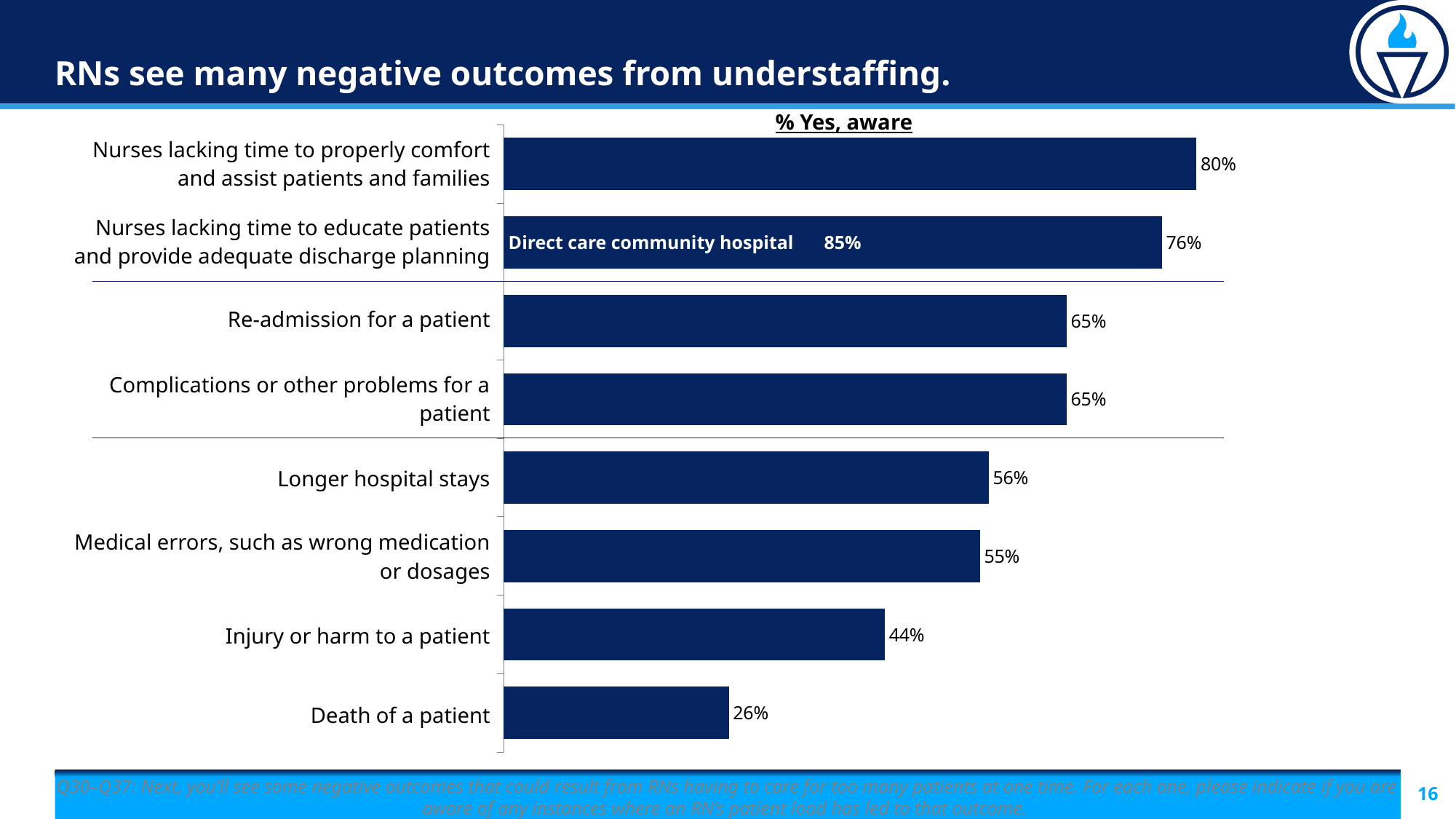
What is the value for 'Death of a patient'? 26% What is the difference between the value for 'Nurses lacking time to properly comfort and assist patients and families' and the value for 'Death of a patient'? 54 percentage points What percentage of RNs are aware of nurses lacking time to properly comfort and assist patients and families? 80% What is the value for 'Re-admission for a patient'? 65% How many outcome categories are shown in the chart? 8 What is the difference between the value for 'Nurses lacking time to educate patients and provide adequate discharge planning' and the value for 'Re-admission for a patient'? 11 percentage points What kind of chart is shown on the slide? bar chart What is the value for 'Injury or harm to a patient'? 44% Which is larger: the value for 'Longer hospital stays' or the value for 'Injury or harm to a patient'? Longer hospital stays What value is shown in the annotation for 'Direct care community hospital'? 85% Which outcome has the highest percentage of RNs aware? Nurses lacking time to properly comfort and assist patients and families Which outcome has the lowest percentage of RNs aware? Death of a patient